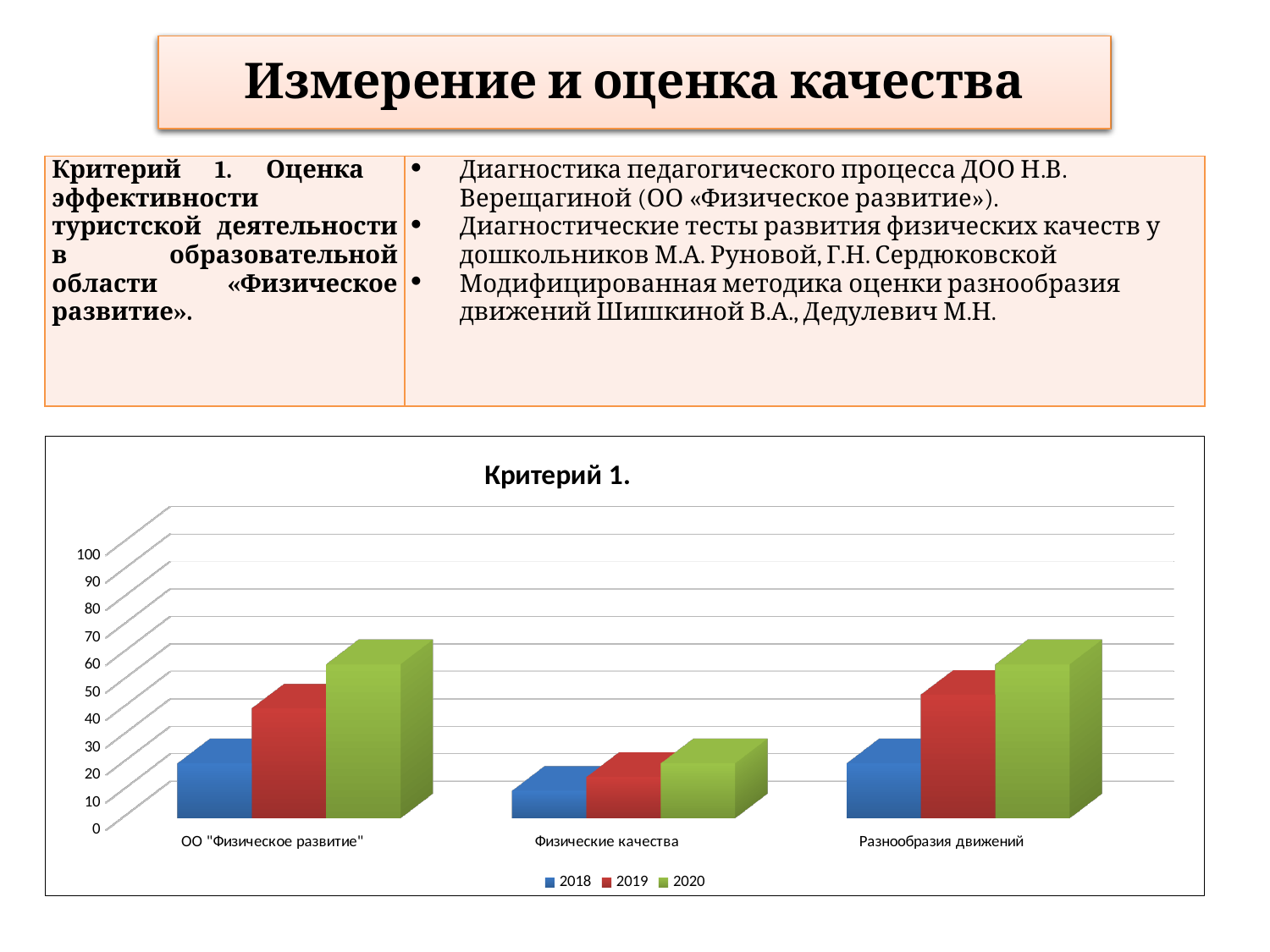
Is the 2020 value for ОО "Физическое развитие" greater or less than 40? greater Which is larger: the 2019 value for ОО "Физическое развитие" or the 2019 value for Физические качества? ОО "Физическое развитие" What is the title of the chart? Критерий 1. How many series does the chart legend list? 3 What kind of chart is shown on the slide? bar chart Is the 2020 value for Физические качества greater or less than 50? less For the category Разнообразия движений, do the values rise or fall from 2018 to 2020? rise How many categories are shown on the x axis of the chart? 3 For the category Физические качества, which year has the lowest value? 2018 Which years are listed in the chart legend? 2018, 2019, 2020 Which category has the lowest 2020 value? Физические качества For the category ОО "Физическое развитие", which year has the highest value? 2020